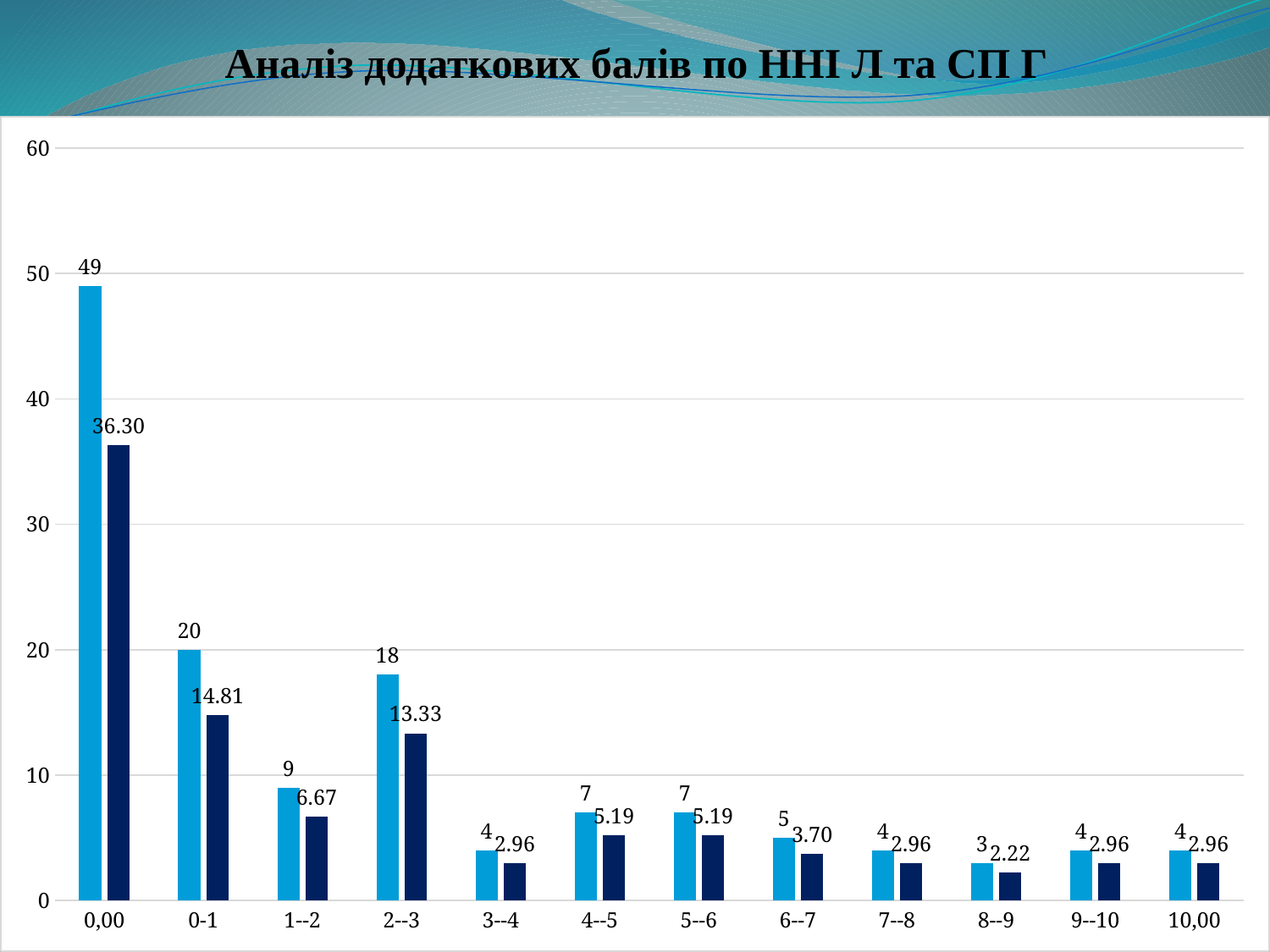
What is the value of the dark blue bar for the category 0,00? 36.30 How many categories are shown on the x axis? 12 What is the value of the dark blue bar for the category 2--3? 13.33 What is the title of the chart? Аналіз додаткових балів по ННІ Л та СП Г Which category has the lowest dark blue bar? 8--9 What is the difference between the light blue bars for 0-1 and 2--3? 2 Which is larger: the dark blue bar for 1--2 or the dark blue bar for 6--7? 1--2 What is the value of the light blue bar for the category 0,00? 49 Which category has the highest light blue bar? 0,00 What kind of chart is shown on the slide? bar chart What is the value of the light blue bar for the category 8--9? 3 Is the light blue bar for 0,00 greater or less than 40? greater